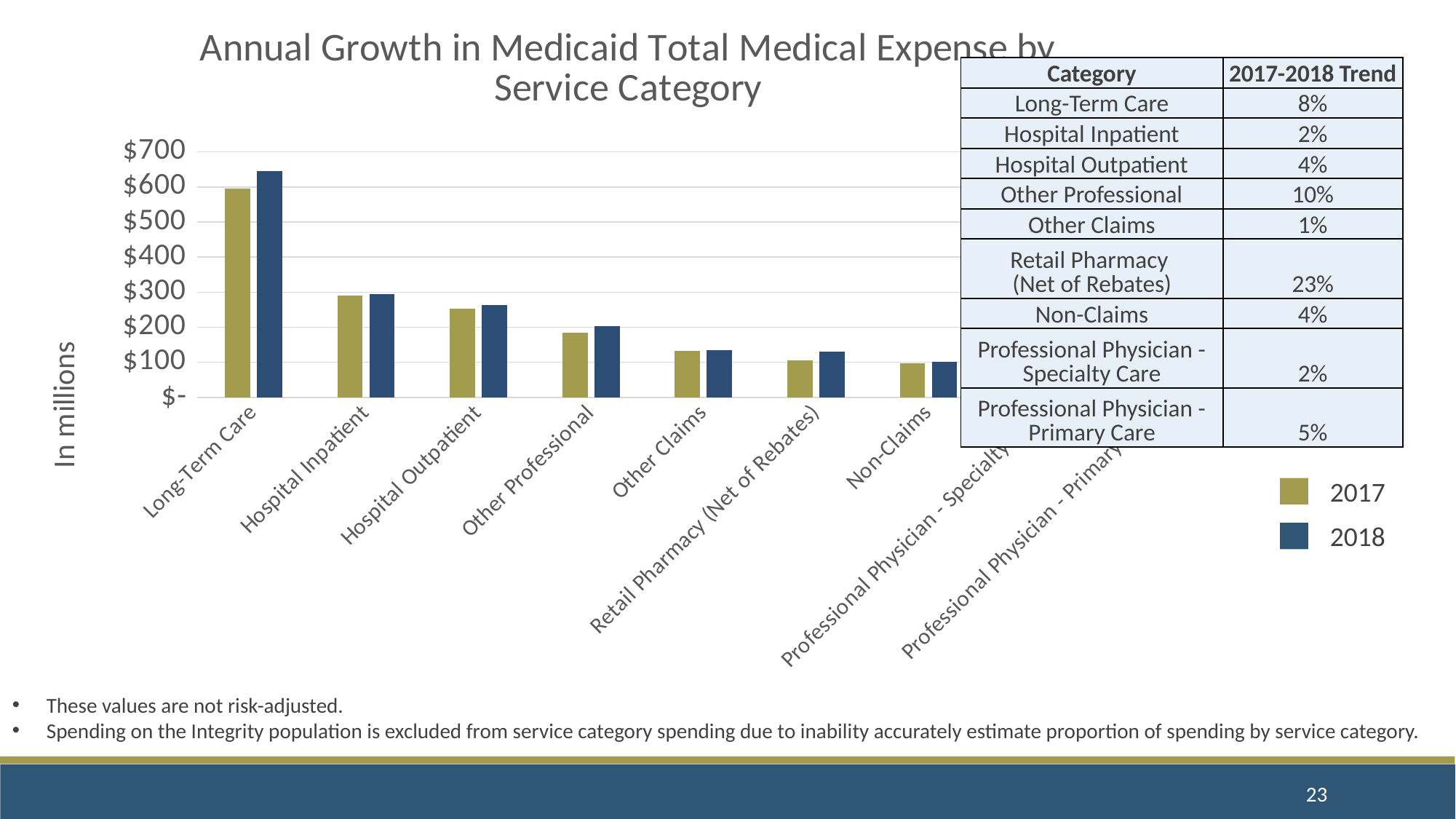
What kind of chart is shown on the slide? Bar chart Is the 2017 value for Other Professional greater or less than $200? less Which years are listed in the chart legend? 2017 and 2018 For Retail Pharmacy (Net of Rebates), which year has the larger value, 2017 or 2018? 2018 Is the 2017 value for Long-Term Care greater or less than $500? greater How many series does the legend list? 2 Which service category has the highest total medical expense in the chart? Long-Term Care What is the label on the vertical axis of the chart? In millions Is the 2018 value for Hospital Outpatient greater or less than $200? greater For Long-Term Care, which year has the larger value, 2017 or 2018? 2018